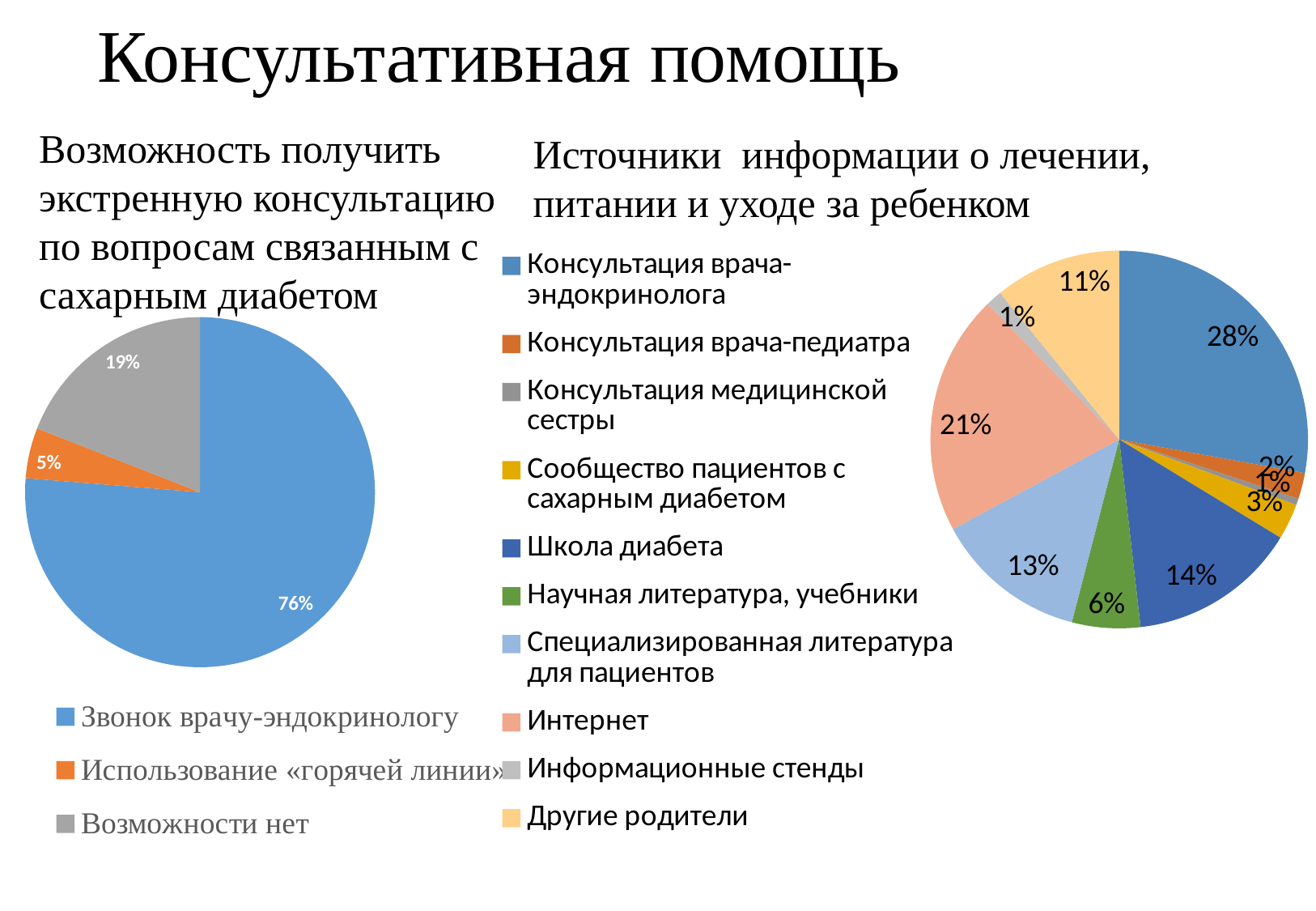
What type of chart is used for both charts on the slide? Pie chart In the left pie chart about the possibility of getting an emergency consultation, what is the difference between 'Звонок врачу-эндокринологу' and 'Возможности нет'? 57% In the left pie chart about the possibility of getting an emergency consultation, what share is 'Возможности нет'? 19% In the right pie chart 'Источники информации о лечении, питании и уходе за ребенком', which source has the largest share? Консультация врача-эндокринолога In the left pie chart about the possibility of getting an emergency consultation, what share is 'Звонок врачу-эндокринологу'? 76% In the right pie chart 'Источники информации о лечении, питании и уходе за ребенком', which is larger: 'Специализированная литература для пациентов' or 'Другие родители'? Специализированная литература для пациентов In the right pie chart 'Источники информации о лечении, питании и уходе за ребенком', what share is 'Консультация врача-эндокринолога'? 28% In the left pie chart about the possibility of getting an emergency consultation, how many categories does the legend list? 3 In the left pie chart about the possibility of getting an emergency consultation, which category has the smallest share? Использование «горячей линии» In the right pie chart 'Источники информации о лечении, питании и уходе за ребенком', what share is 'Интернет'? 21% In the right pie chart 'Источники информации о лечении, питании и уходе за ребенком', what share is 'Школа диабета'? 14% In the right pie chart 'Источники информации о лечении, питании и уходе за ребенком', how many categories does the legend list? 10